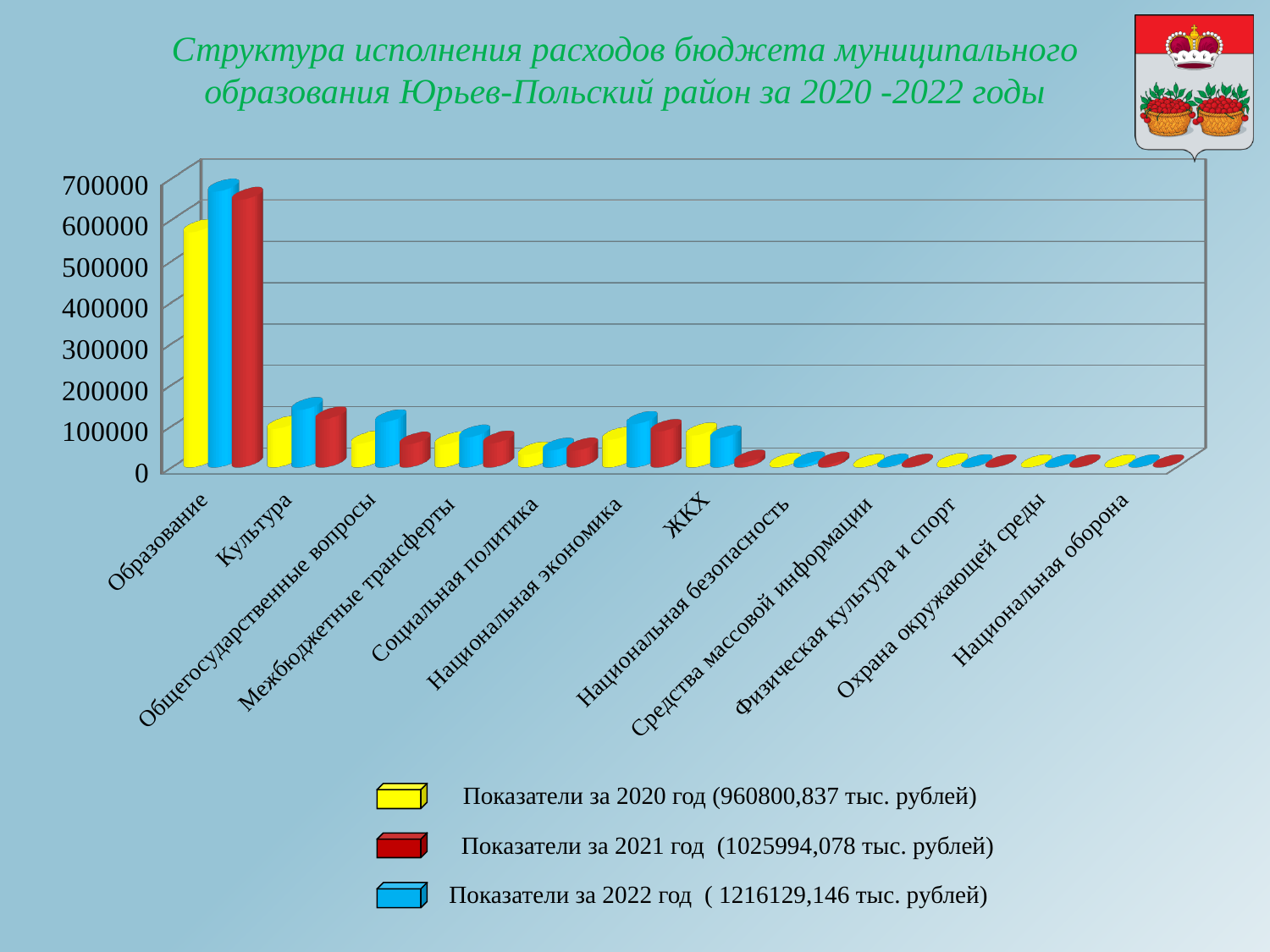
According to the legend, what total is given for the 2021 indicators? 1025994,078 тыс. рублей Which category has the highest bars in the chart? Образование Is the 2022 value for Образование greater or less than 600000? greater Is the 2020 value for Социальная политика greater or less than 100000? less What kind of chart is shown on the slide? bar chart How many series does the legend list? 3 How many expenditure categories are shown along the x axis? 12 Which is larger for Культура: the 2020 value or the 2022 value? 2022 Do the values generally rise or fall moving from left to right along the x axis? fall Is the 2020 value for Образование greater or less than 500000? greater Which is larger for ЖКХ: the 2020 value or the 2021 value? 2020